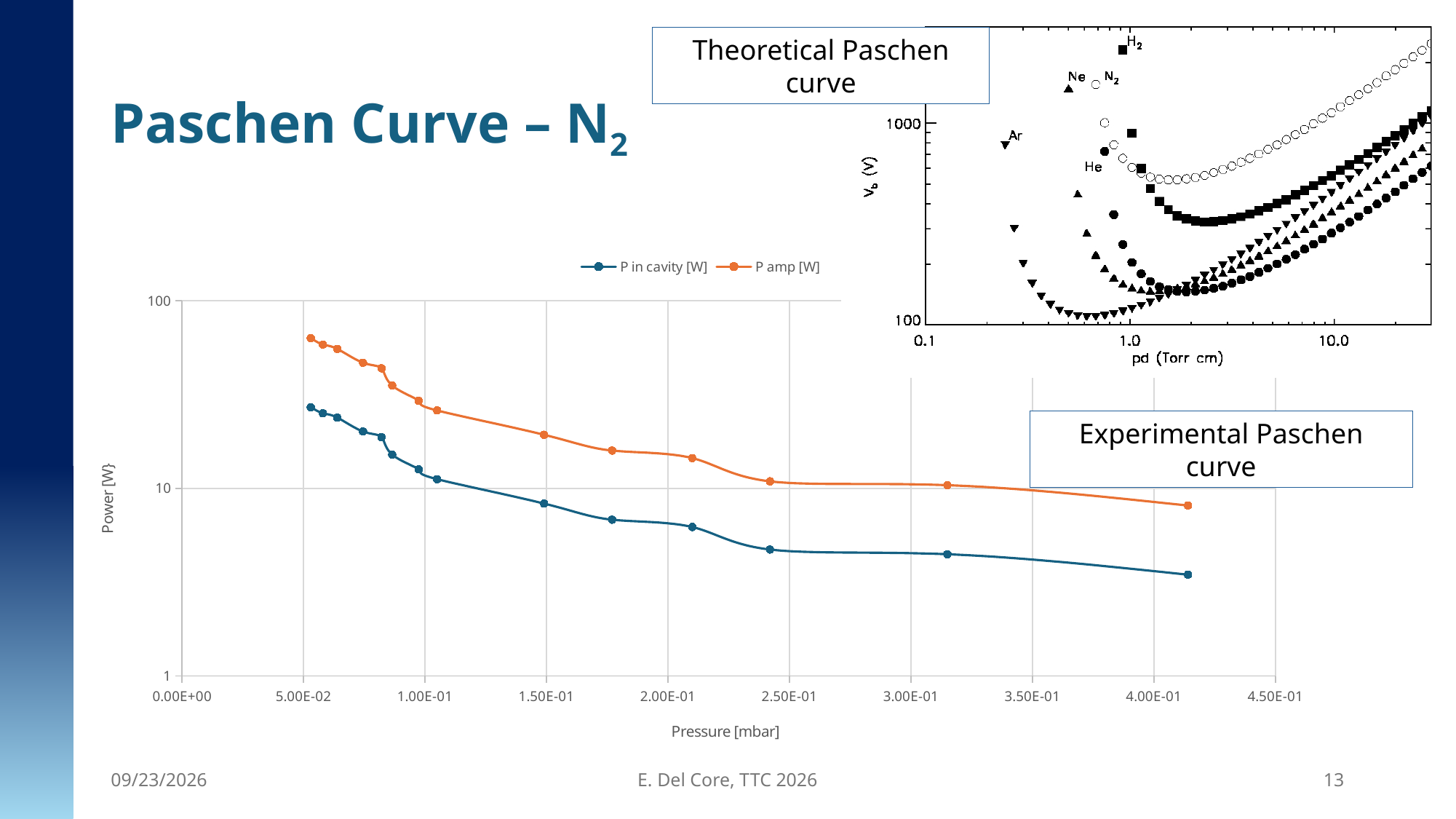
In the experimental Paschen curve chart, is the value of P in cavity [W] at the lowest pressure greater or less than 10? greater In the theoretical Paschen curve chart, which gas has the lowest minimum breakdown voltage? Ar In the experimental Paschen curve chart, do the values of P amp [W] rise or fall as pressure increases? Fall In the experimental Paschen curve chart, which series has the higher values, P in cavity [W] or P amp [W]? P amp [W] In the theoretical Paschen curve chart, how many gases are labelled? 5 In the experimental Paschen curve chart, what is the label of the x axis? Pressure [mbar] In the experimental Paschen curve chart, how many series does the legend list? 2 What kind of chart is the experimental Paschen curve chart? Line chart In the experimental Paschen curve chart, is the value of P amp [W] at the lowest pressure greater or less than 10? greater In the experimental Paschen curve chart, what are the two series named in the legend? P in cavity [W] and P amp [W] In the theoretical Paschen curve chart, which gas has the highest minimum breakdown voltage? N2 In the experimental Paschen curve chart, is the value of P in cavity [W] at the highest pressure greater or less than 10? less